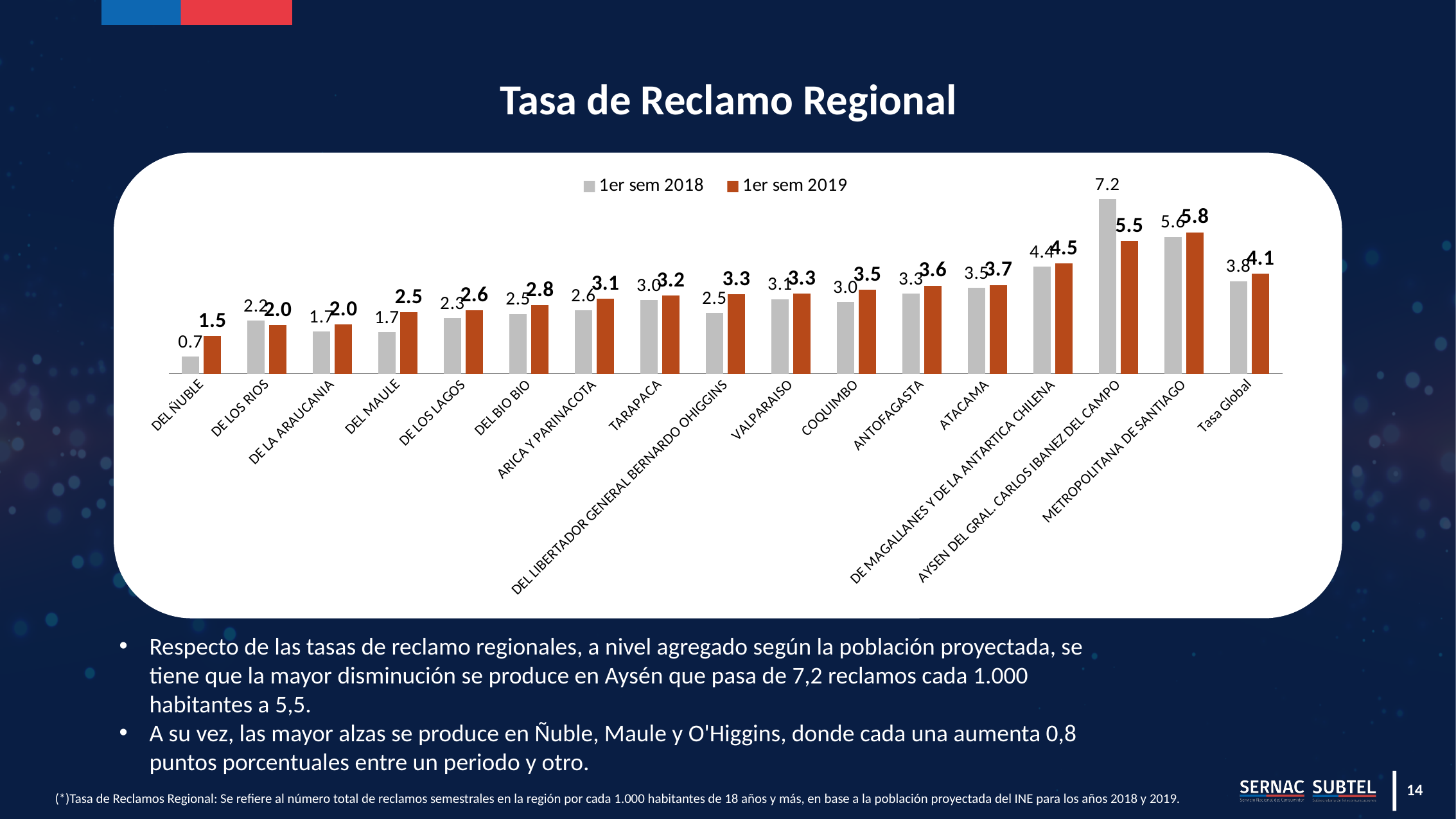
Which category has the highest value in the 1er sem 2018 series? AYSEN DEL GRAL. CARLOS IBANEZ DEL CAMPO What is the value for DEL ÑUBLE in the 1er sem 2018 series? 0.7 What is the value for AYSEN DEL GRAL. CARLOS IBANEZ DEL CAMPO in the 1er sem 2018 series? 7.2 What is the title of the chart? Tasa de Reclamo Regional How many series does the legend list? 2 What is the difference between the 1er sem 2018 and 1er sem 2019 values for AYSEN DEL GRAL. CARLOS IBANEZ DEL CAMPO? 1.7 Which is larger for DE LOS RIOS: the 1er sem 2018 value or the 1er sem 2019 value? 1er sem 2018 What kind of chart is shown on the slide? Bar chart How many categories are shown on the x axis? 17 Which category has the lowest value in the 1er sem 2019 series? DEL ÑUBLE What is the value for DEL MAULE in the 1er sem 2019 series? 2.5 What is the value for DEL ÑUBLE in the 1er sem 2019 series? 1.5